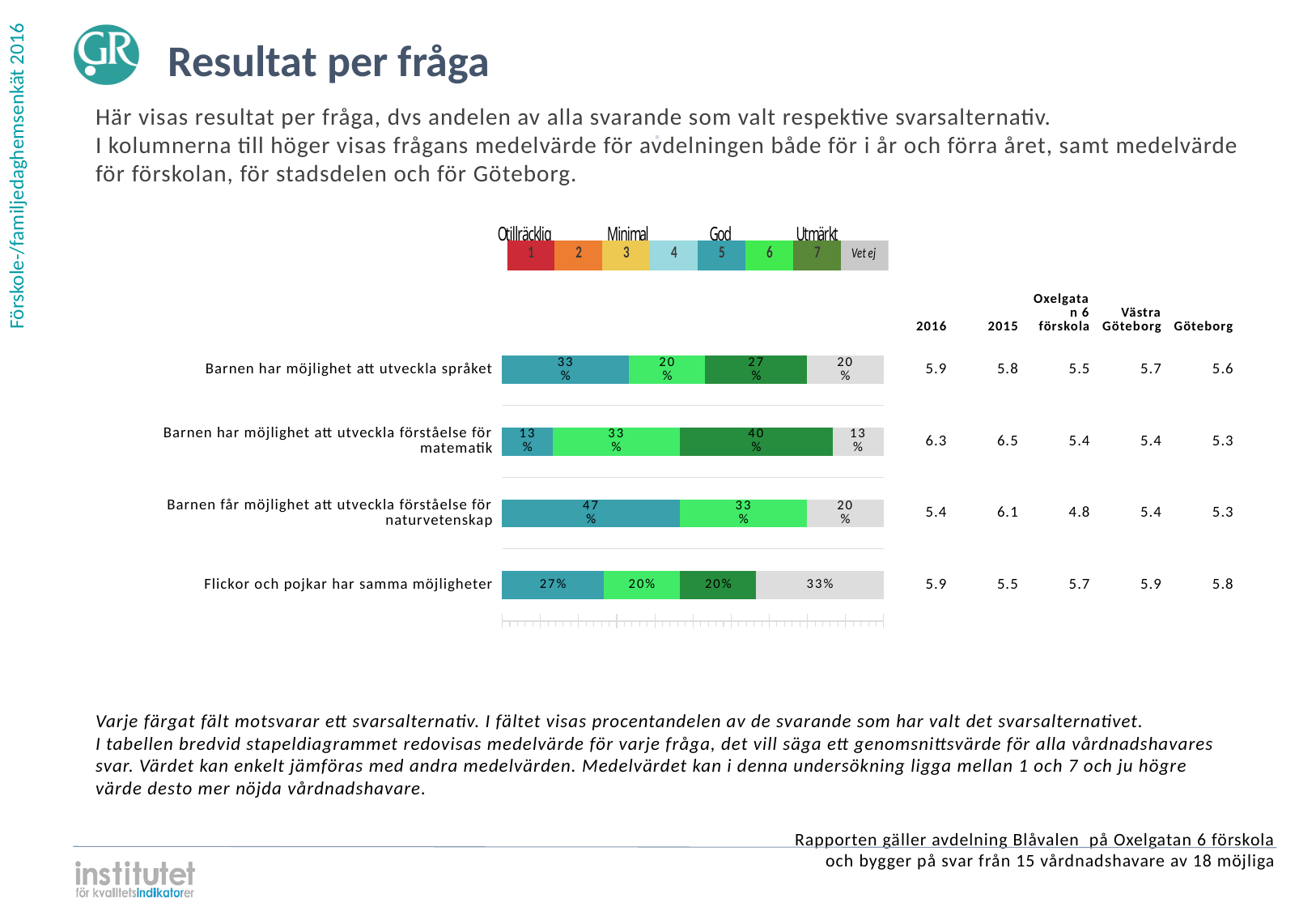
What is the 2016 mean value shown next to the bar for 'Barnen har möjlighet att utveckla förståelse för matematik'? 6.3 Which is larger: the option 5 share for 'Barnen får möjlighet att utveckla förståelse för naturvetenskap' or for 'Barnen har möjlighet att utveckla språket'? Barnen får möjlighet att utveckla förståelse för naturvetenskap What is the 'Vet ej' (grey) share for 'Flickor och pojkar har samma möjligheter'? 33% What kind of chart is shown on the slide? Stacked bar chart What percentage of respondents chose option 5 (teal) for 'Barnen får möjlighet att utveckla förståelse för naturvetenskap'? 47% Which question has the largest 'Vet ej' (grey) share? Flickor och pojkar har samma möjligheter How many response options does the colour legend above the chart list? 8 What is the total of the segments in the bar for 'Barnen har möjlighet att utveckla språket'? 100% How many questions (categories) are plotted as bars in the chart? 4 What percentage of respondents chose option 7 (dark green) for 'Barnen har möjlighet att utveckla förståelse för matematik'? 40% What is the difference between the option 7 share for 'Barnen har möjlighet att utveckla förståelse för matematik' and for 'Barnen har möjlighet att utveckla språket'? 13% Which question has the smallest 'Vet ej' (grey) share? Barnen har möjlighet att utveckla förståelse för matematik